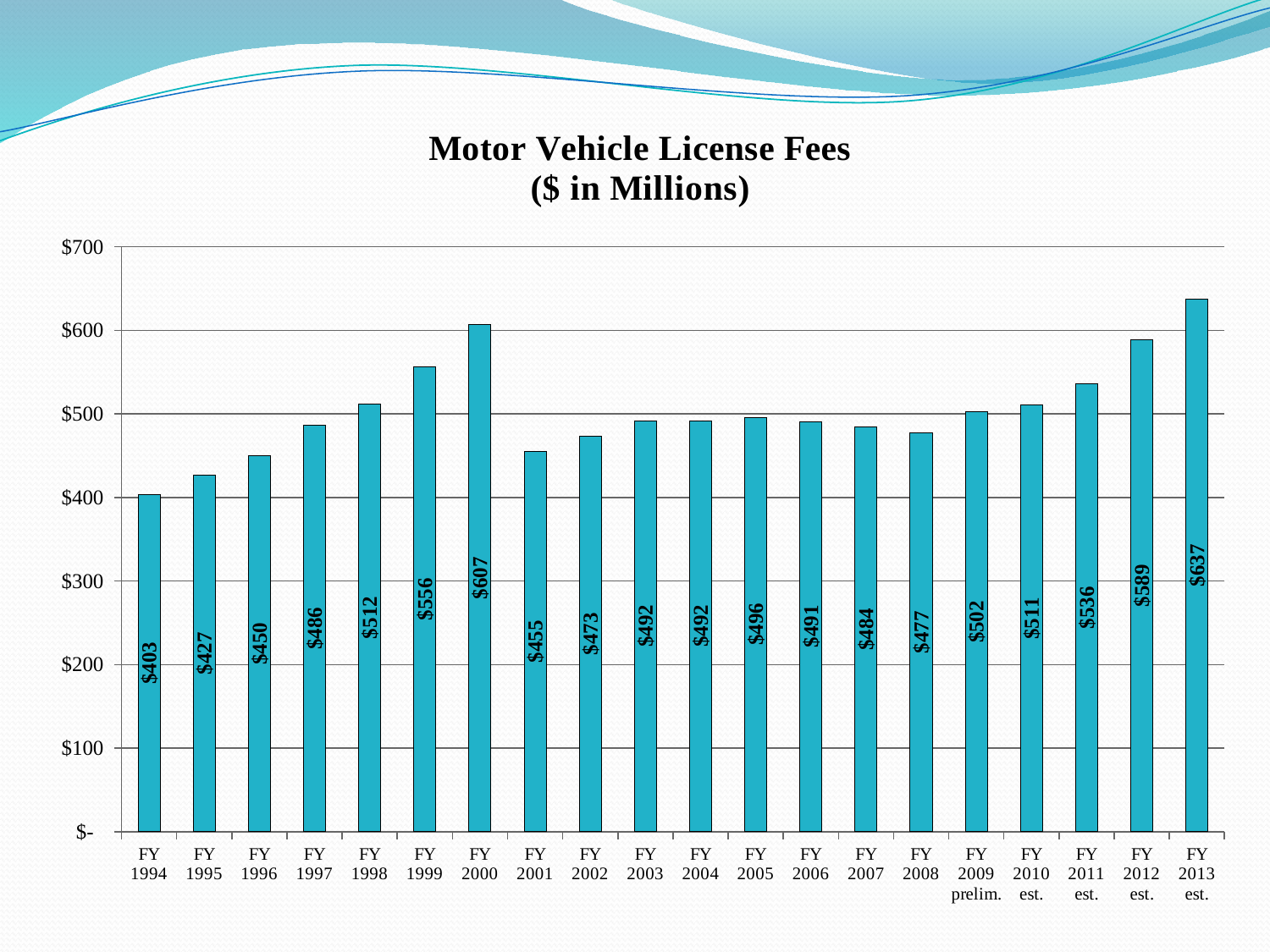
What is the difference between the values for FY 2013 est. and FY 1994? $234 How many fiscal years are shown on the x axis? 20 What is the value for FY 2009 prelim.? $502 What kind of chart is this? bar chart Do the values rise or fall from FY 1994 to FY 2000? rise What is the title of the chart? Motor Vehicle License Fees ($ in Millions) Which is larger, the value for FY 1999 or the value for FY 2012 est.? FY 2012 est. Is the value for FY 2008 greater or less than $500? less Which fiscal year has the lowest value? FY 1994 Which fiscal year has the highest value? FY 2013 est. What is the value for FY 2000? $607 What is the difference between the values for FY 2000 and FY 2001? $152